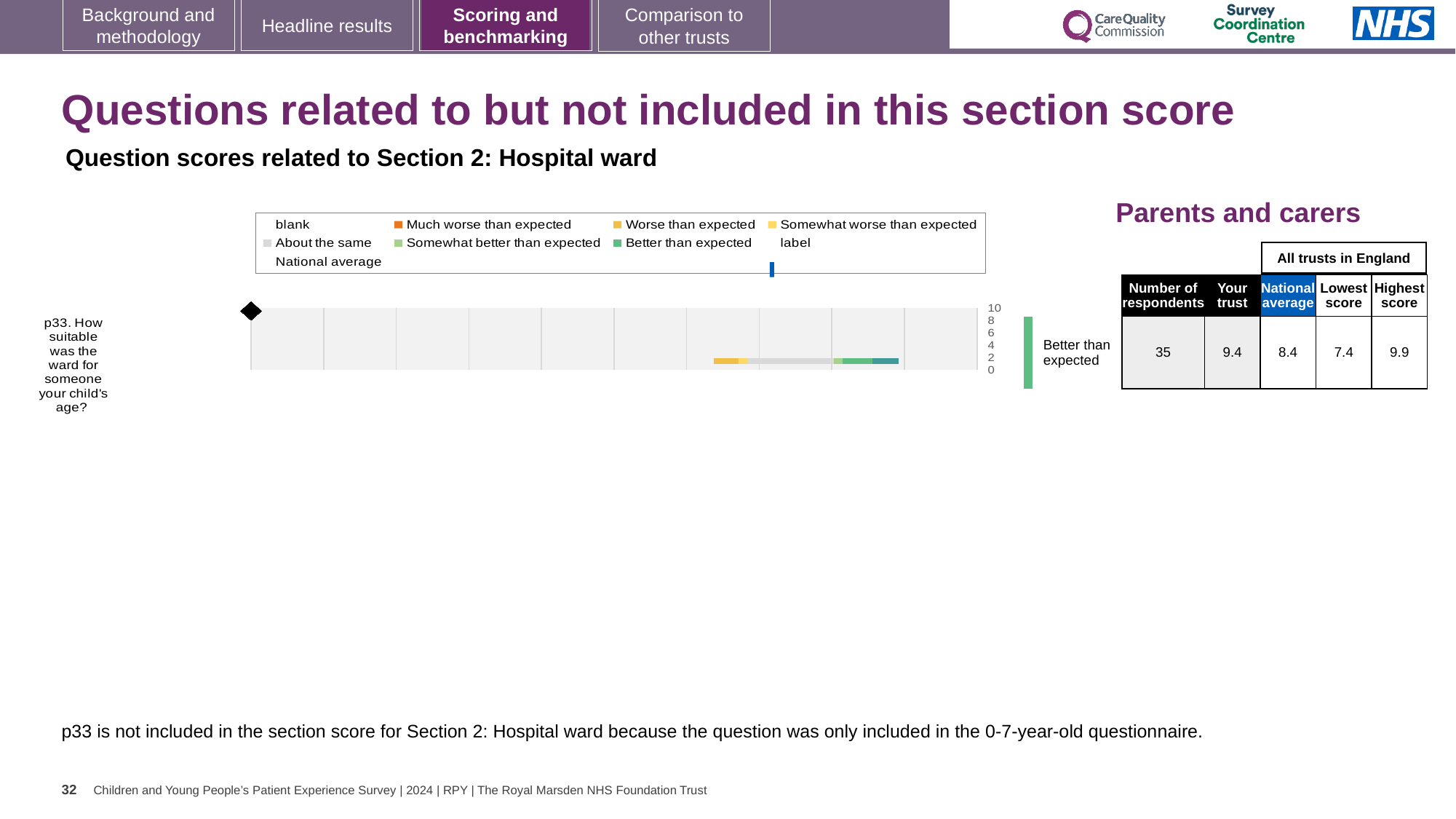
What is the 'Your trust' score for p33? 9.4 Which question is plotted in the chart? p33. How suitable was the ward for someone your child's age? What is the difference between the 'Your trust' score and the national average for p33? 1.0 What kind of chart is used to show the p33 question score? bar chart How many questions are plotted in the chart? 1 What rating is shown next to the chart for p33? Better than expected What is the maximum value shown on the chart's score axis? 10 What is the national average score for p33? 8.4 What is the highest score among all trusts in England for p33? 9.9 What is the lowest score among all trusts in England for p33? 7.4 Which is larger for p33, the 'Your trust' score or the national average? Your trust How many respondents answered p33? 35